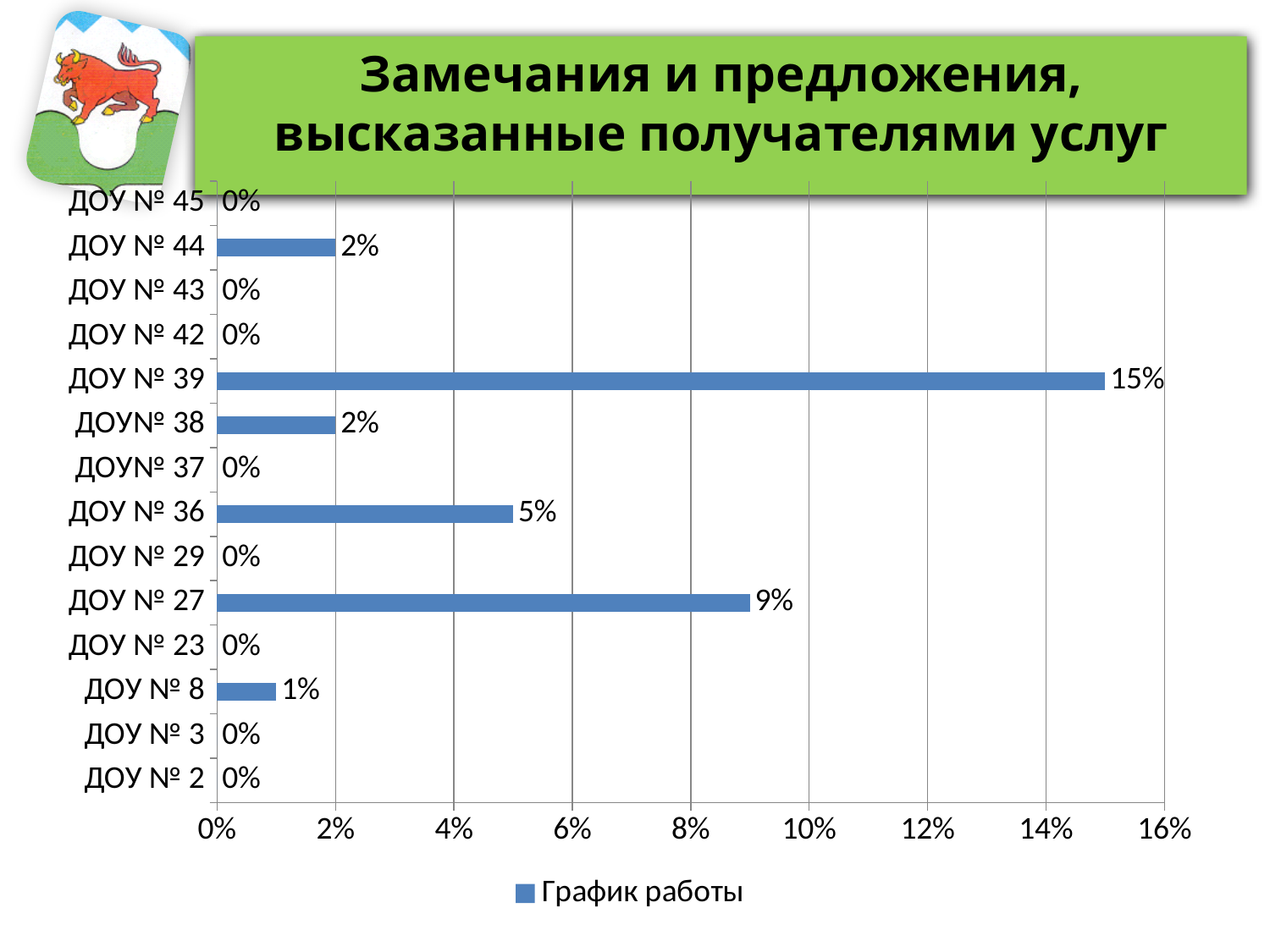
Which category has the highest value? ДОУ № 39 Which is larger, the value for ДОУ № 27 or the value for ДОУ № 36? ДОУ № 27 How many categories are shown on the chart? 14 What value is shown for ДОУ № 27? 9% What is the difference between the values for ДОУ № 39 and ДОУ № 27? 6% What is the difference between the values for ДОУ № 36 and ДОУ № 44? 3% How many series does the legend list? 1 What is the name of the series in the legend? График работы What value is shown for ДОУ № 39? 15% What kind of chart is shown on the slide? bar chart What value is shown for ДОУ № 36? 5% What value is shown for ДОУ № 8? 1%